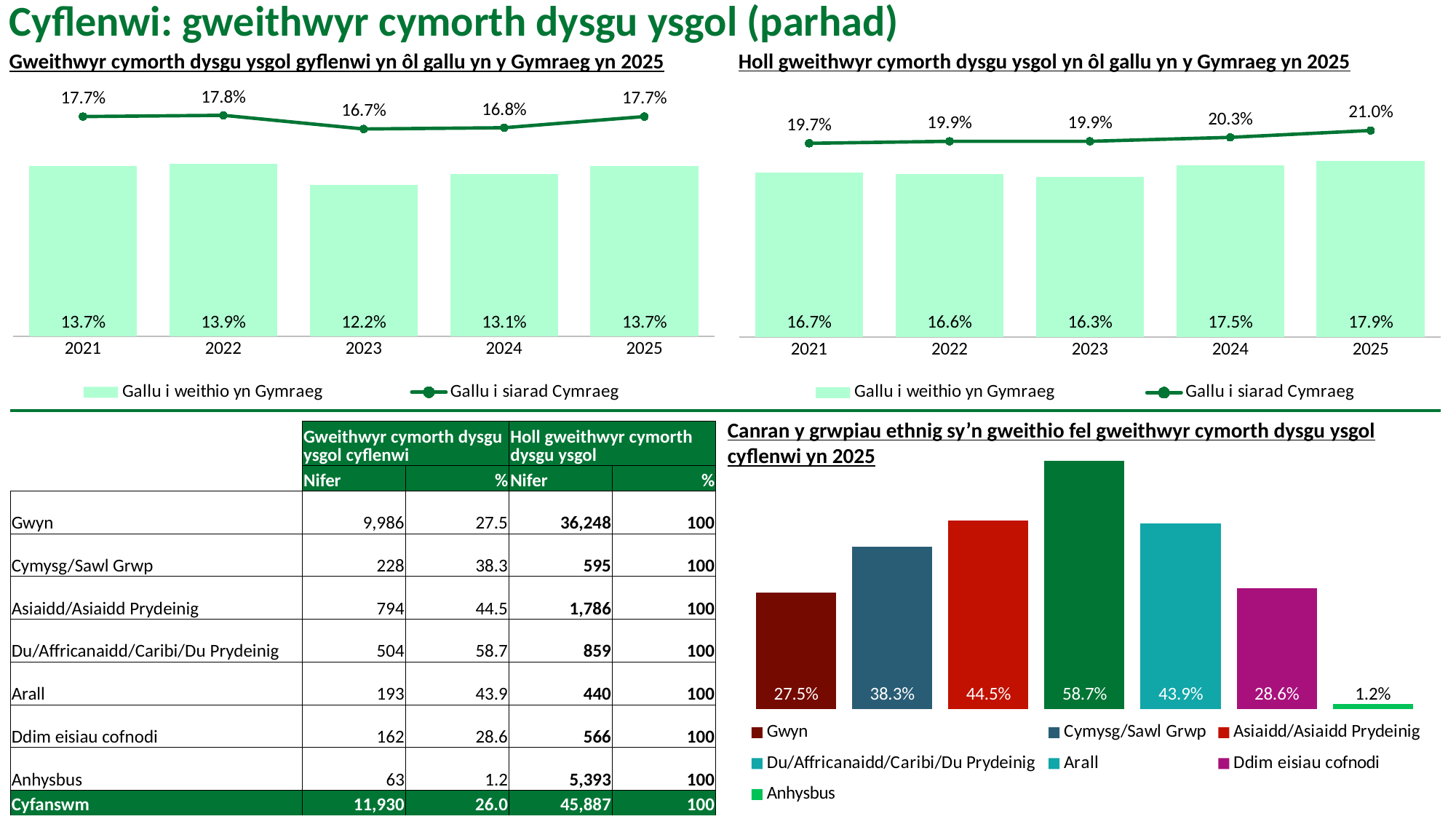
In the chart titled 'Gweithwyr cymorth dysgu ysgol gyflenwi yn ôl gallu yn y Gymraeg yn 2025', what is the value for 'Gallu i siarad Cymraeg' in 2022? 17.8% In the chart titled 'Gweithwyr cymorth dysgu ysgol gyflenwi yn ôl gallu yn y Gymraeg yn 2025', which year has the lowest value for 'Gallu i weithio yn Gymraeg'? 2023 In the chart titled 'Holl gweithwyr cymorth dysgu ysgol yn ôl gallu yn y Gymraeg yn 2025', which year has the highest value for 'Gallu i weithio yn Gymraeg'? 2025 In the chart titled 'Holl gweithwyr cymorth dysgu ysgol yn ôl gallu yn y Gymraeg yn 2025', does the 'Gallu i siarad Cymraeg' series rise or fall from 2023 to 2025? rise In the chart titled 'Canran y grwpiau ethnig sy'n gweithio fel gweithwyr cymorth dysgu ysgol cyflenwi yn 2025', which is larger: the value for 'Asiaidd/Asiaidd Prydeinig' or the value for 'Arall'? Asiaidd/Asiaidd Prydeinig In the chart titled 'Holl gweithwyr cymorth dysgu ysgol yn ôl gallu yn y Gymraeg yn 2025', what is the value for 'Gallu i siarad Cymraeg' in 2025? 21.0% In the chart titled 'Canran y grwpiau ethnig sy'n gweithio fel gweithwyr cymorth dysgu ysgol cyflenwi yn 2025', what is the value for 'Du/Affricanaidd/Caribi/Du Prydeinig'? 58.7% In the chart titled 'Canran y grwpiau ethnig sy'n gweithio fel gweithwyr cymorth dysgu ysgol cyflenwi yn 2025', which group has the lowest value? Anhysbus What kind of chart is the chart titled 'Canran y grwpiau ethnig sy'n gweithio fel gweithwyr cymorth dysgu ysgol cyflenwi yn 2025'? bar chart In the chart titled 'Gweithwyr cymorth dysgu ysgol gyflenwi yn ôl gallu yn y Gymraeg yn 2025', what is the difference between the 'Gallu i siarad Cymraeg' and 'Gallu i weithio yn Gymraeg' values in 2025? 4.0% In the chart titled 'Holl gweithwyr cymorth dysgu ysgol yn ôl gallu yn y Gymraeg yn 2025', how many series does the legend list? 2 In the chart titled 'Gweithwyr cymorth dysgu ysgol gyflenwi yn ôl gallu yn y Gymraeg yn 2025', what is the value for 'Gallu i weithio yn Gymraeg' in 2023? 12.2%